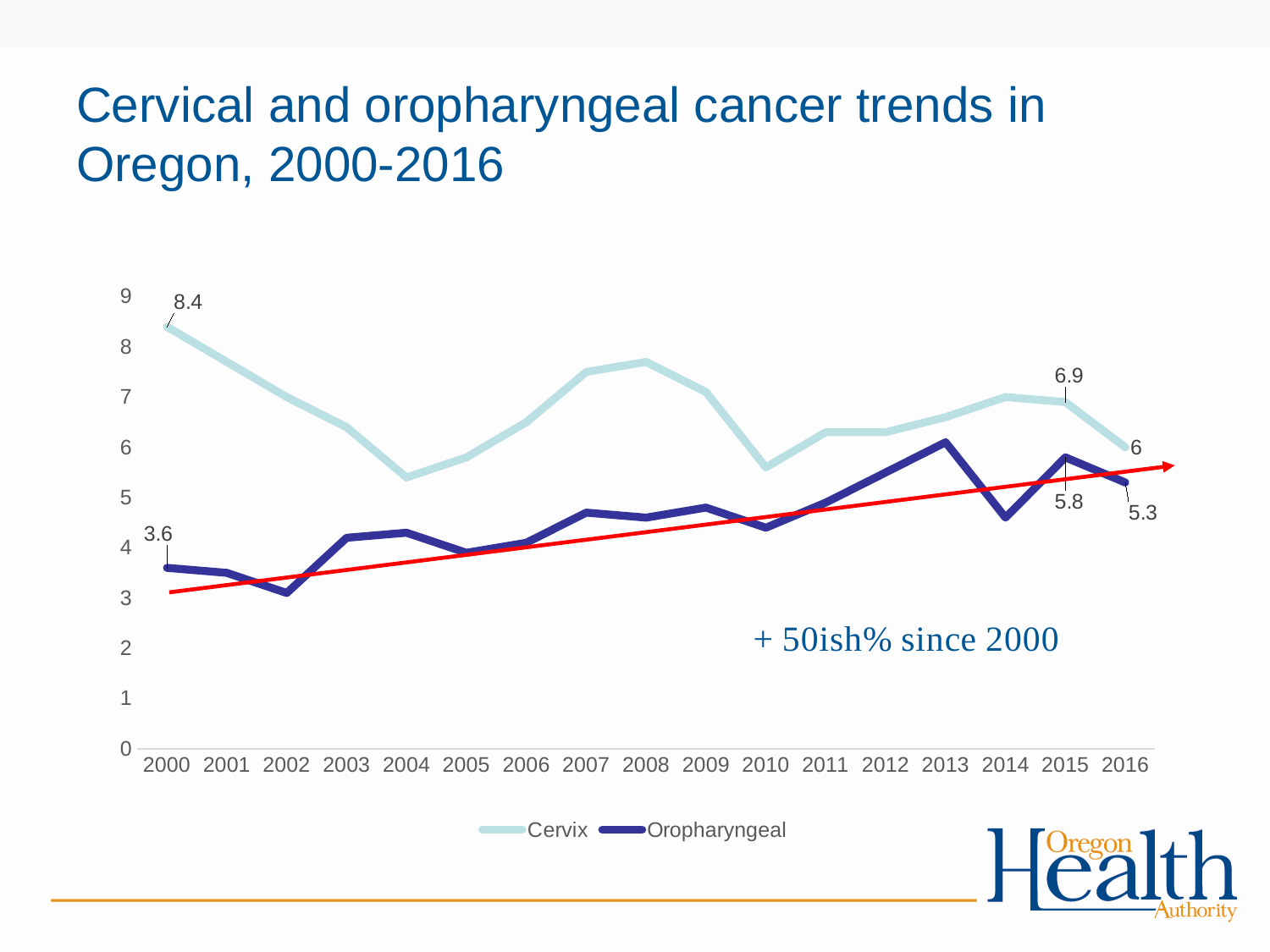
Does the Oropharyngeal series generally rise or fall from 2000 to 2016? rise What is the Cervix value in 2000? 8.4 Is the Oropharyngeal value for 2002 greater or less than 4? less What is the Oropharyngeal value in 2015? 5.8 How many years are shown on the x axis? 17 What is the Oropharyngeal value in 2000? 3.6 In 2016, which series has the higher value, Cervix or Oropharyngeal? Cervix What is the difference between the Cervix values in 2000 and 2016? 2.4 By how much did the Oropharyngeal value change from 2000 (3.6) to 2016 (5.3)? 1.7 What is the Cervix value in 2016? 6 In which year is the Cervix series at its highest? 2000 How many series does the legend list? 2